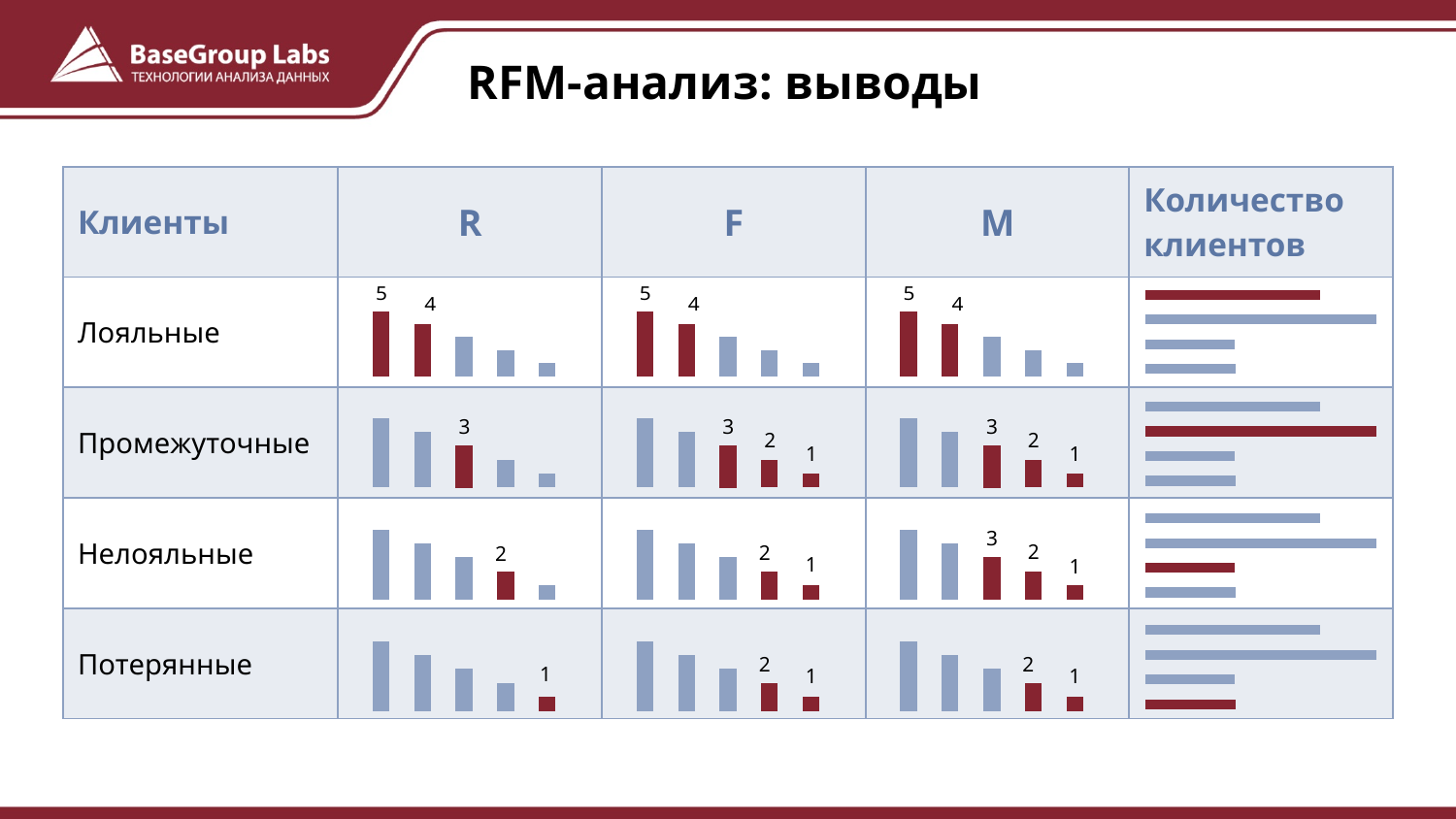
How many customer groups (rows) are shown in the table? 4 Do the bars in each mini chart rise or fall from left to right? fall In the R chart for the Промежуточные row, what is the label of the red bar? 3 How many bars does each mini bar chart in the R, F and M columns contain? 5 In the R chart for the Потерянные row, what is the label of the red bar? 1 In the R chart for the Нелояльные row, what is the label of the red bar? 2 In the M chart for the Нелояльные row, which bars are labelled? 3, 2 and 1 In the R chart for the Лояльные row, which bars are highlighted in red (by their labels)? 5 and 4 In the F chart for the Лояльные row, which bar is the highest? 5 In the Количество клиентов column, which row has the longest red bar? Промежуточные In the F chart for the Промежуточные row, how many bars are highlighted in red? 3 What kind of chart is used in the R, F and M cells of the table? bar chart